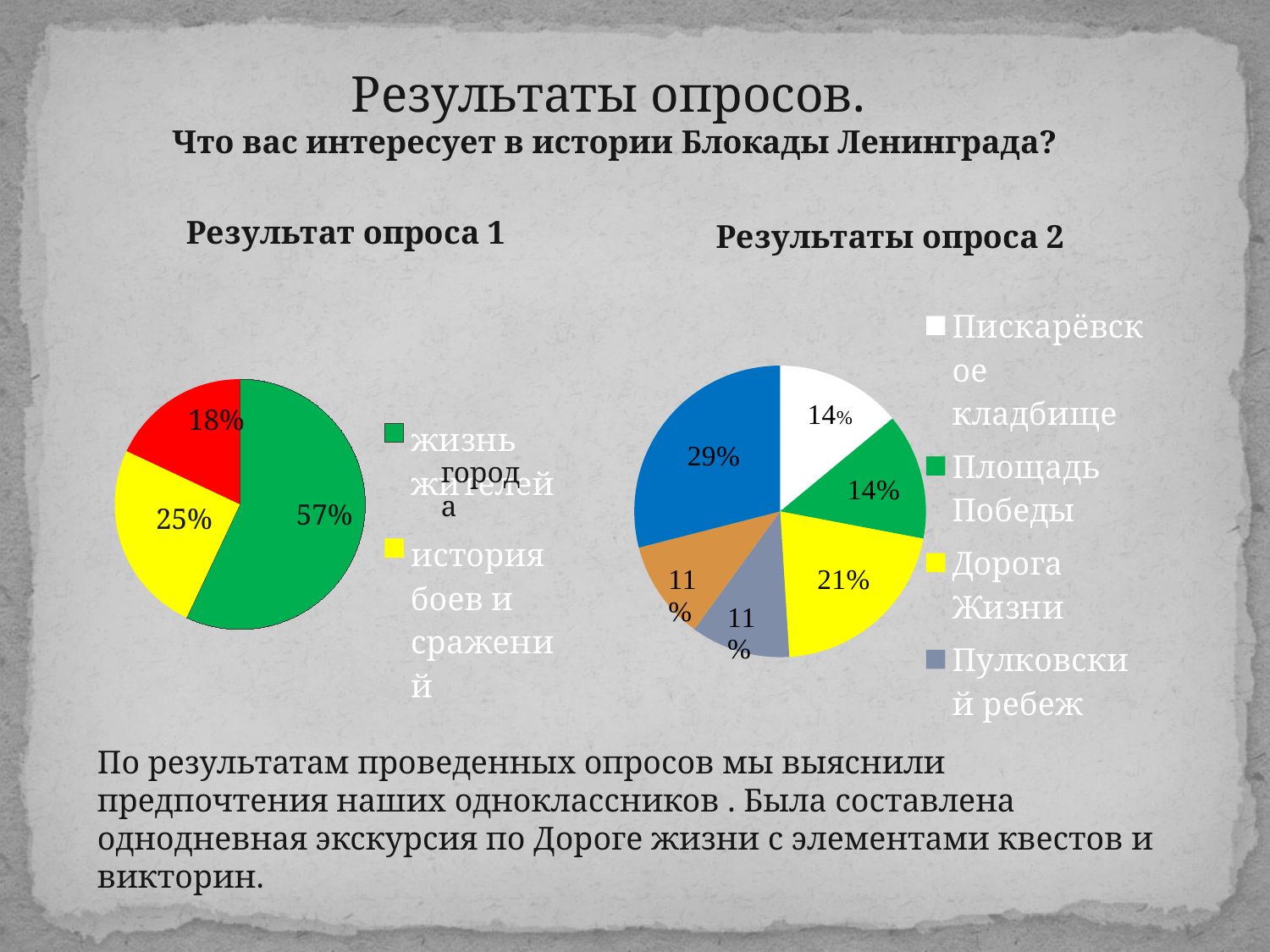
In the chart 'Результат опроса 1', what share is shown for 'жизнь жителей'? 57% In the chart 'Результат опроса 1', what is the difference between the largest slice (57%) and the 25% slice? 32% In the chart 'Результаты опроса 2', what share is shown for 'Пулковский рубеж'? 11% In the chart 'Результаты опроса 2', which is larger: the share for 'Дорога Жизни' or the share for 'Пискарёвское кладбище'? Дорога Жизни In the chart 'Результат опроса 1', how many slices does the pie have? 3 In the chart 'Результаты опроса 2', how many slices does the pie have? 6 In the chart 'Результаты опроса 2', what is the largest percentage shown on any slice? 29% In the chart 'Результаты опроса 2', what share is shown for 'Площадь Победы'? 14% In the chart 'Результат опроса 1', what share is shown for 'история боев и сражений'? 25% What kind of chart is 'Результаты опроса 2'? pie chart In the chart 'Результаты опроса 2', what share is shown for 'Дорога Жизни'? 21% In the chart 'Результат опроса 1', which category has the largest slice? жизнь жителей